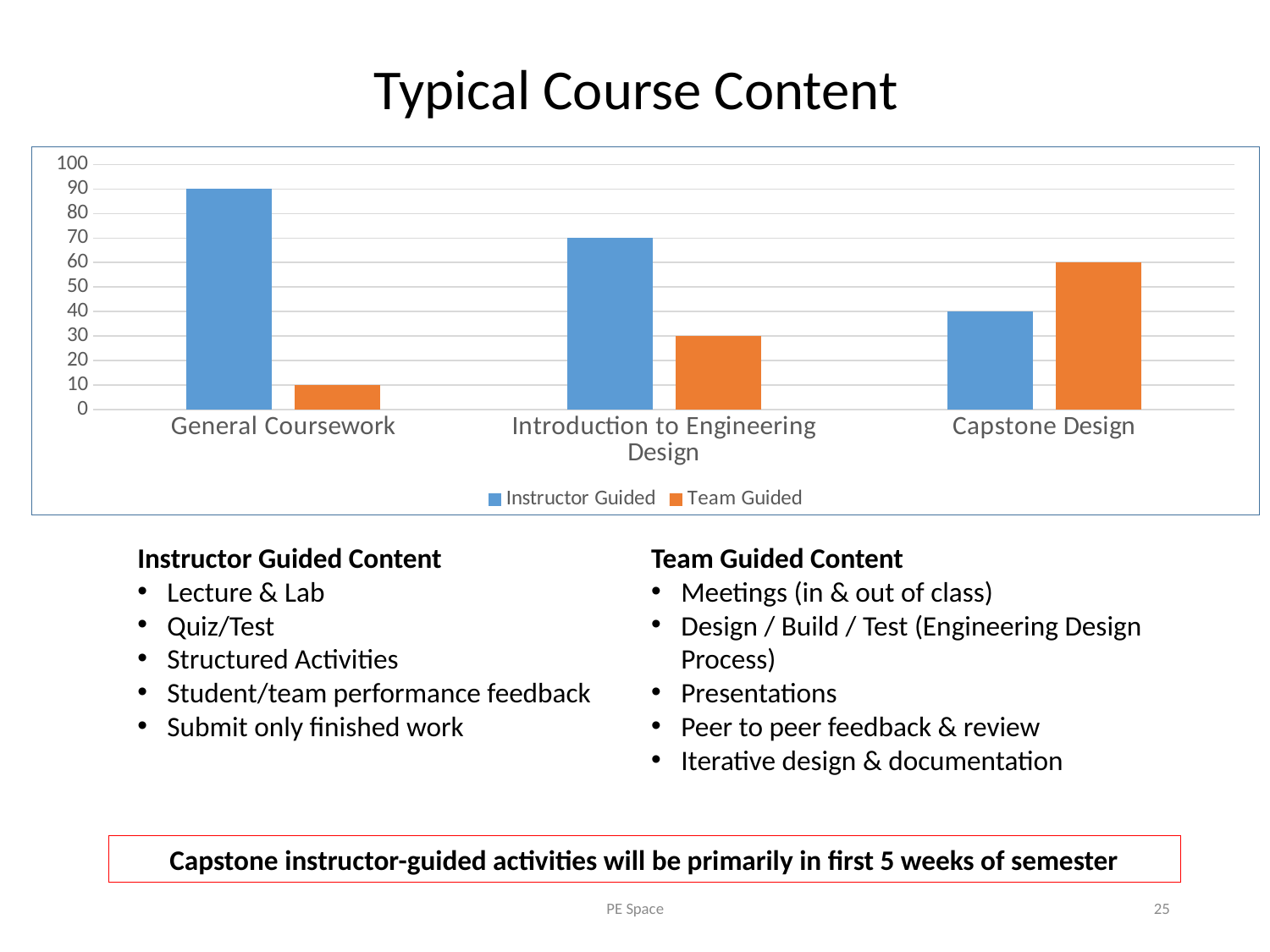
What is the Team Guided value for Capstone Design? 60 How many categories are shown on the x axis? 3 What is the Instructor Guided value for General Coursework? 90 For Capstone Design, which is larger: Instructor Guided or Team Guided? Team Guided Which category has the lowest Team Guided value? General Coursework What is the difference between the Instructor Guided and Team Guided values for General Coursework? 80 What kind of chart is shown on the slide? bar chart Do the Team Guided values rise or fall from General Coursework to Capstone Design? rise Is the Instructor Guided value for Introduction to Engineering Design greater or less than 50? greater Which category has the highest Instructor Guided value? General Coursework How many series does the legend list? 2 What is the Team Guided value for Introduction to Engineering Design? 30